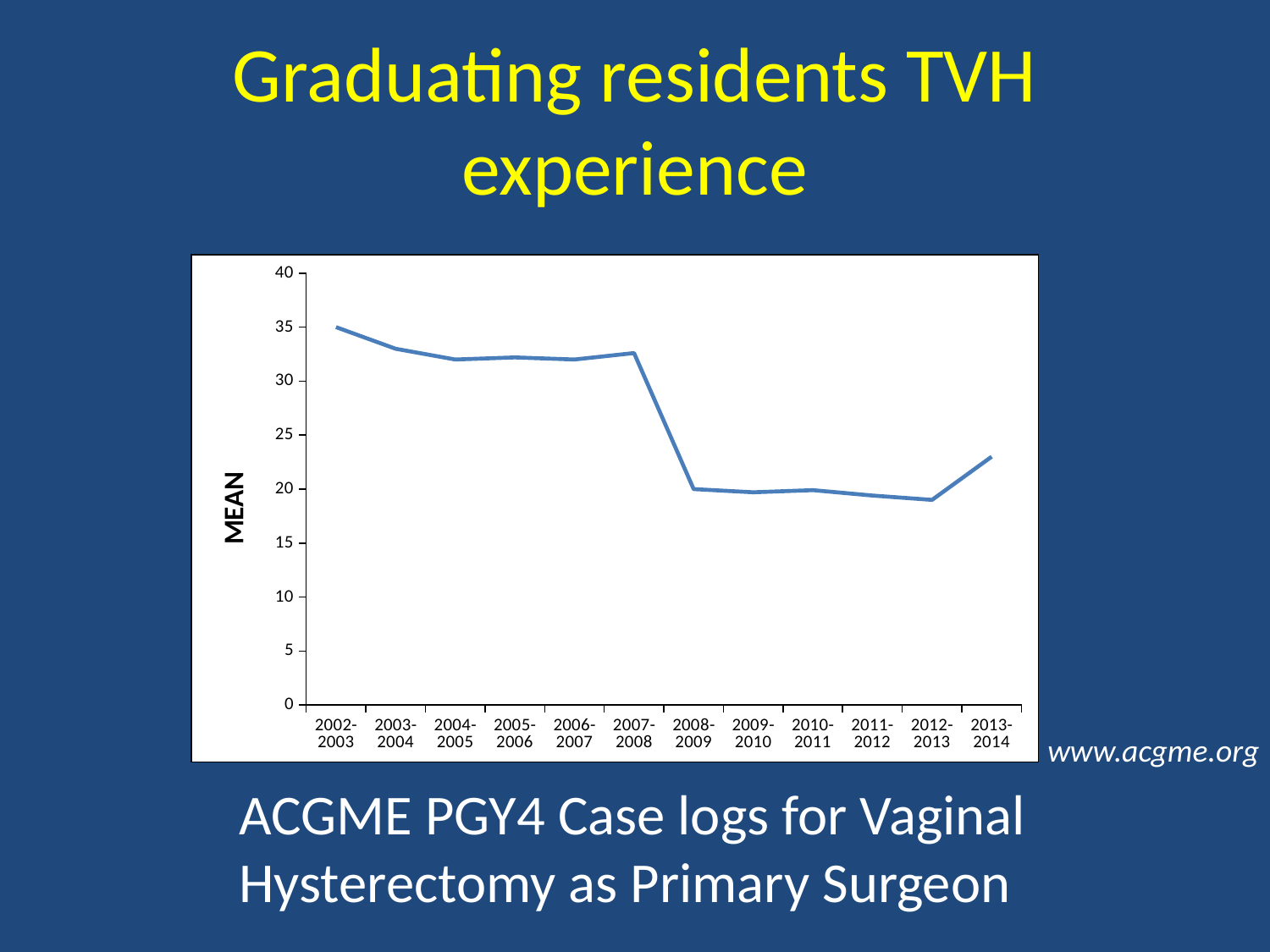
Which is larger, the value for 2007-2008 or the value for 2008-2009? 2007-2008 Is the value for 2012-2013 greater or less than 25? less How many academic years are plotted along the x axis? 12 Which academic year has the highest mean value? 2002-2003 Is the value for 2008-2009 greater or less than 25? less Is the value for 2013-2014 greater or less than 20? greater Which is larger, the value for 2012-2013 or the value for 2013-2014? 2013-2014 Overall, do the values rise or fall from 2002-2003 to 2013-2014? fall What is the label on the y axis of the chart? MEAN What kind of chart is shown on the slide? line chart